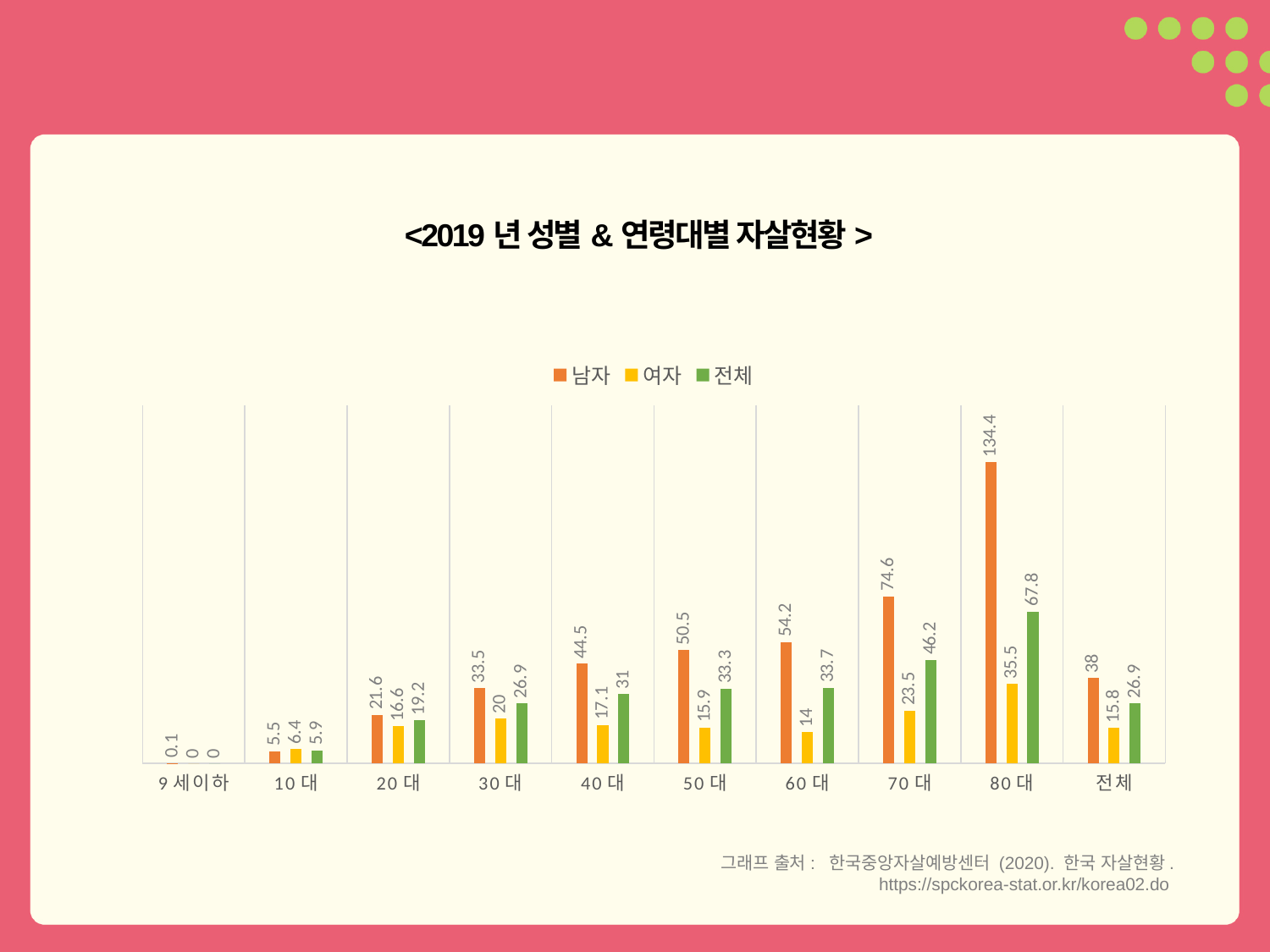
How many categories are shown on the x axis? 10 What colour are the 전체 bars? Green What is the value for 전체 in the 40 대 category? 31 Which age category has the lowest 여자 value? 9 세이하 In the 10 대 category, which is larger, the 남자 value or the 여자 value? 여자 What kind of chart is shown on the slide? Bar chart Do the 남자 values rise or fall from 10 대 to 80 대? Rise What is the value for 남자 in the 80 대 category? 134.4 How many series does the legend list? 3 What is the difference between the 남자 and 여자 values in the 60 대 category? 40.2 Which age category has the highest 남자 value? 80 대 What is the value for 여자 in the 70 대 category? 23.5